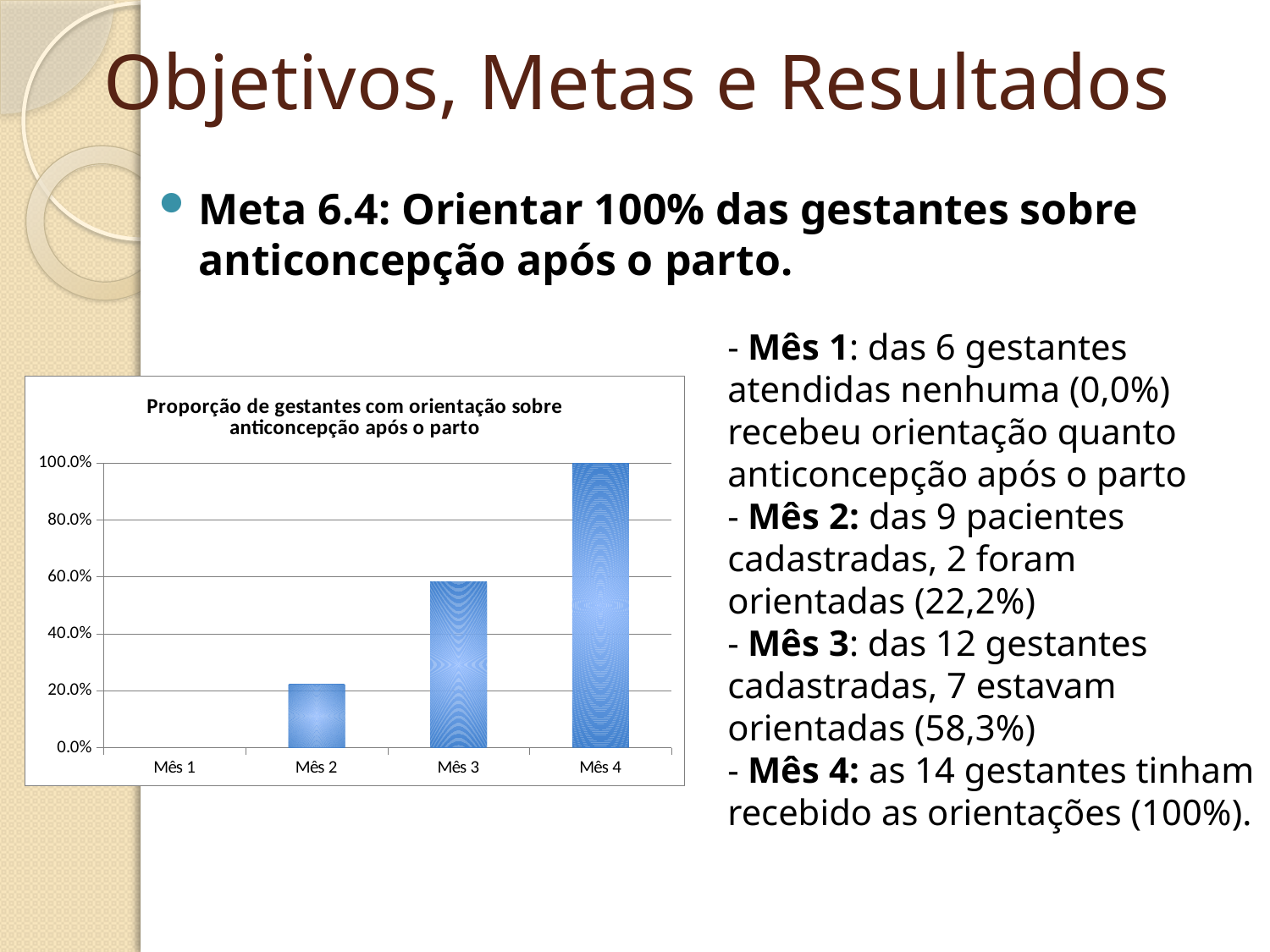
Which is larger, the value for Mês 2 or the value for Mês 3? Mês 3 How many months (categories) are shown on the x axis of the chart? 4 What kind of chart is shown on the slide? bar chart Is the value for Mês 3 greater or less than 40.0%? greater What is the difference between the value for Mês 4 and the value for Mês 1? 100.0% Which month has the lowest proportion in the chart? Mês 1 Is the value for Mês 2 greater or less than 40.0%? less What is the value for Mês 4 in the chart? 100.0% Do the values rise or fall from Mês 1 to Mês 4? rise Which month has the highest proportion in the chart? Mês 4 What is the value for Mês 1 in the chart? 0.0% What is the title of the chart? Proporção de gestantes com orientação sobre anticoncepção após o parto